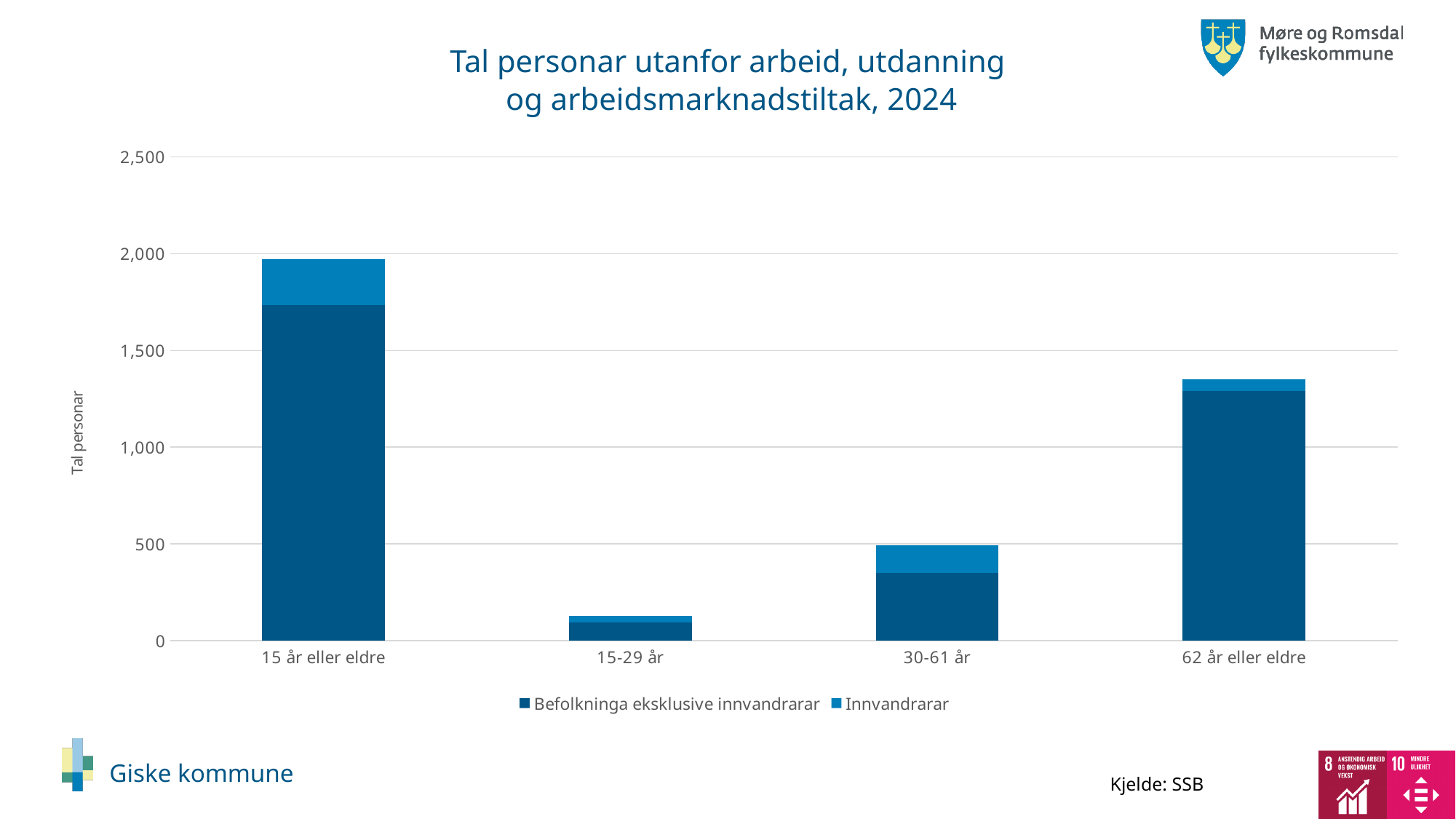
What kind of chart is shown on the slide? Stacked bar chart What is the second series listed in the legend? Innvandrarar Is the total bar for 15-29 år greater or less than 500? less Is the total bar for 15 år eller eldre greater or less than 1,500? greater Is the total bar for 62 år eller eldre greater or less than 1,000? greater Which bar is taller, 62 år eller eldre or 30-61 år? 62 år eller eldre Which age category has the tallest bar? 15 år eller eldre How many age categories are shown on the x axis? 4 Which age category has the shortest bar? 15-29 år What is the label on the vertical axis? Tal personar How many series does the legend list? 2